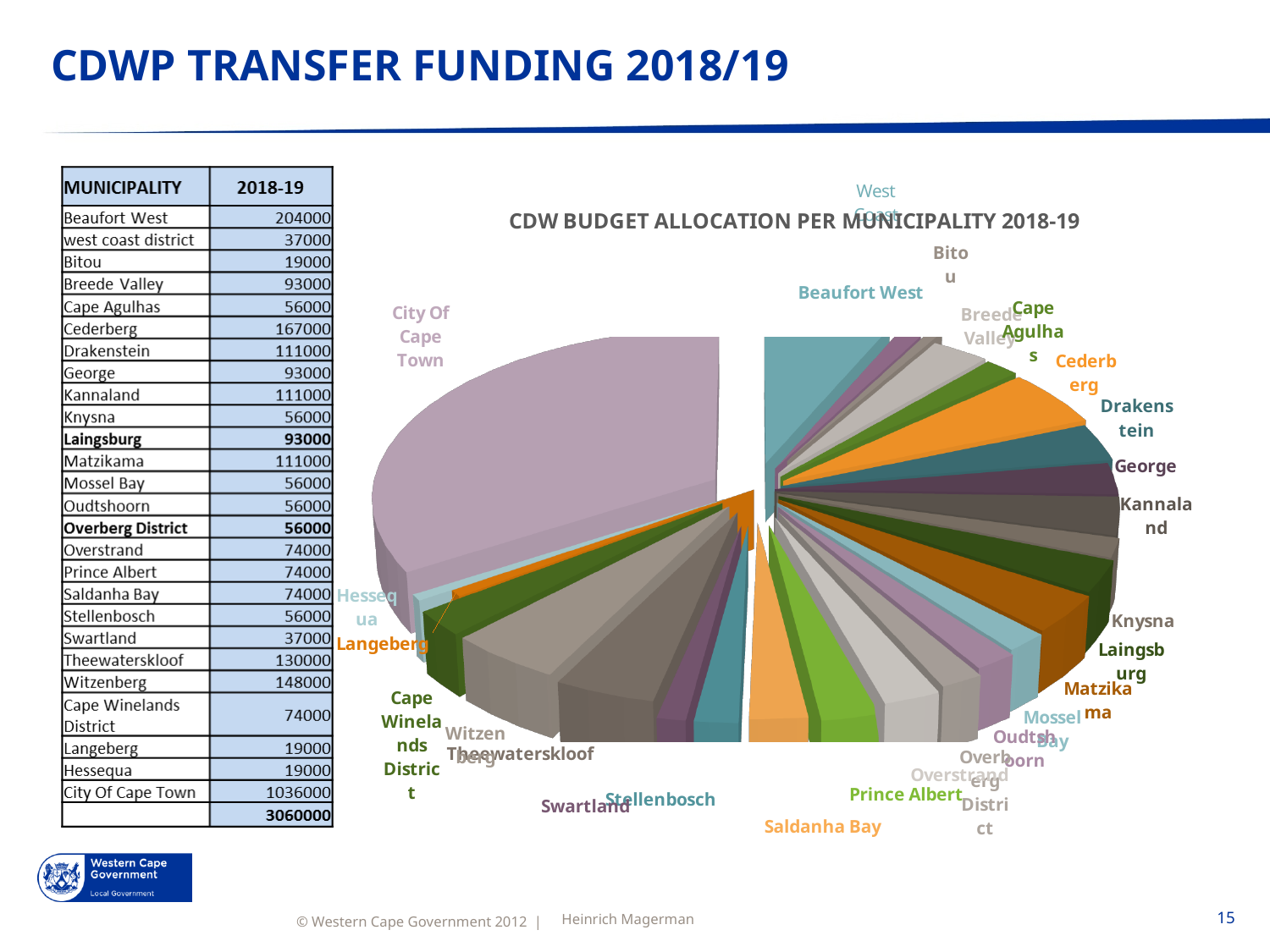
What is the 2018-19 allocation for City Of Cape Town? 1036000 What is the 2018-19 allocation for Beaufort West? 204000 What is the 2018-19 allocation for Theewaterskloof? 130000 What is the total 2018-19 allocation across all municipalities? 3060000 What is the 2018-19 allocation for Witzenberg? 148000 Which has a larger allocation, Cederberg or Drakenstein? Cederberg What is the difference between the allocations for Beaufort West and Cederberg? 37000 What is the title of the chart? CDW BUDGET ALLOCATION PER MUNICIPALITY 2018-19 How many municipalities are shown in the pie chart? 26 What is the difference between the allocations for Witzenberg and Theewaterskloof? 18000 What kind of chart is shown on the slide? pie chart Which municipality has the largest slice in the pie chart? City Of Cape Town